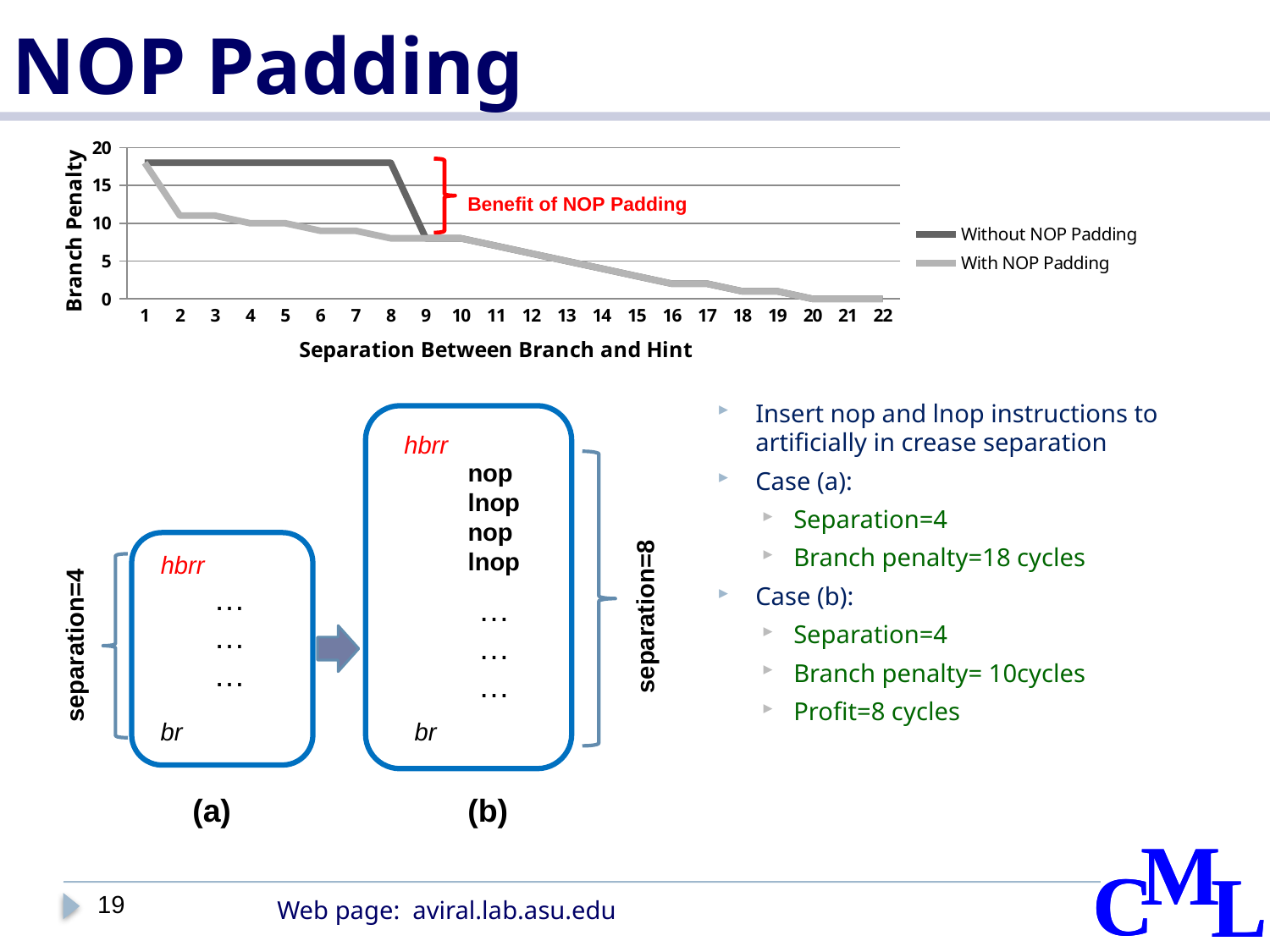
Is the value for With NOP Padding at separation 12 greater or less than 10? less Is the value for Without NOP Padding at separation 8 greater or less than 15? greater At separation 6, which series has the higher branch penalty, Without NOP Padding or With NOP Padding? Without NOP Padding What kind of chart is shown on the slide? line chart Does the With NOP Padding series rise or fall as separation increases along the x axis? fall What are the two series named in the chart legend? Without NOP Padding, With NOP Padding Is the value for With NOP Padding at separation 16 greater or less than 5? less How many series does the chart legend list? 2 What is the label of the chart's x axis? Separation Between Branch and Hint How many separation values are marked along the x axis of the chart? 22